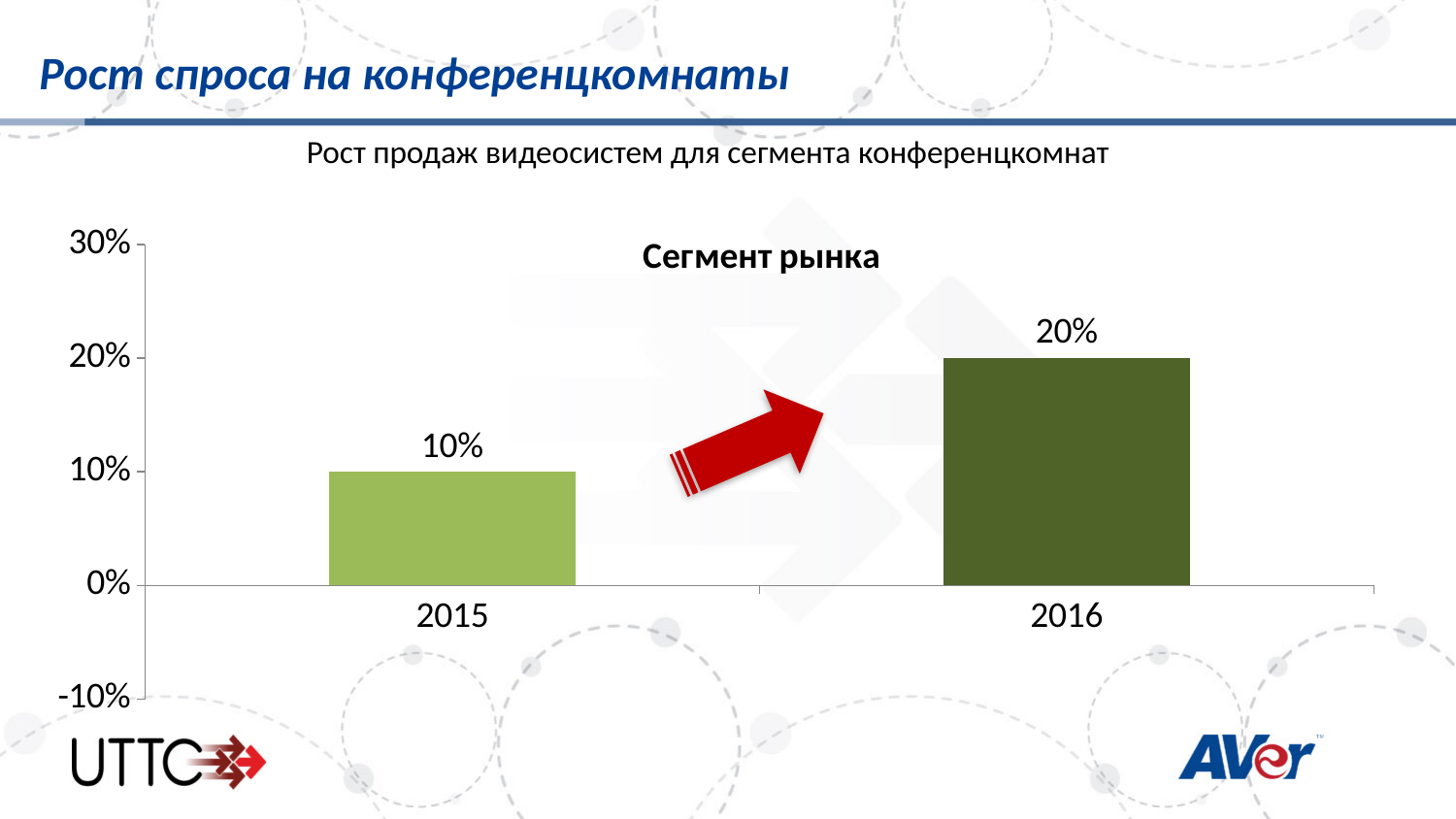
Do the values rise or fall from 2015 to 2016? rise What is the highest value shown on the y axis? 30% How many categories are shown on the x axis? 2 Which year has the highest value? 2016 Which is larger, the value for 2015 or the value for 2016? 2016 Is the value for 2016 greater or less than 10%? greater What is the value for 2015? 10% What is the value for 2016? 20% What kind of chart is shown on the slide? bar chart What is the difference between the values for 2016 and 2015? 10% Which year has the lowest value? 2015 What is the title of the chart? Сегмент рынка